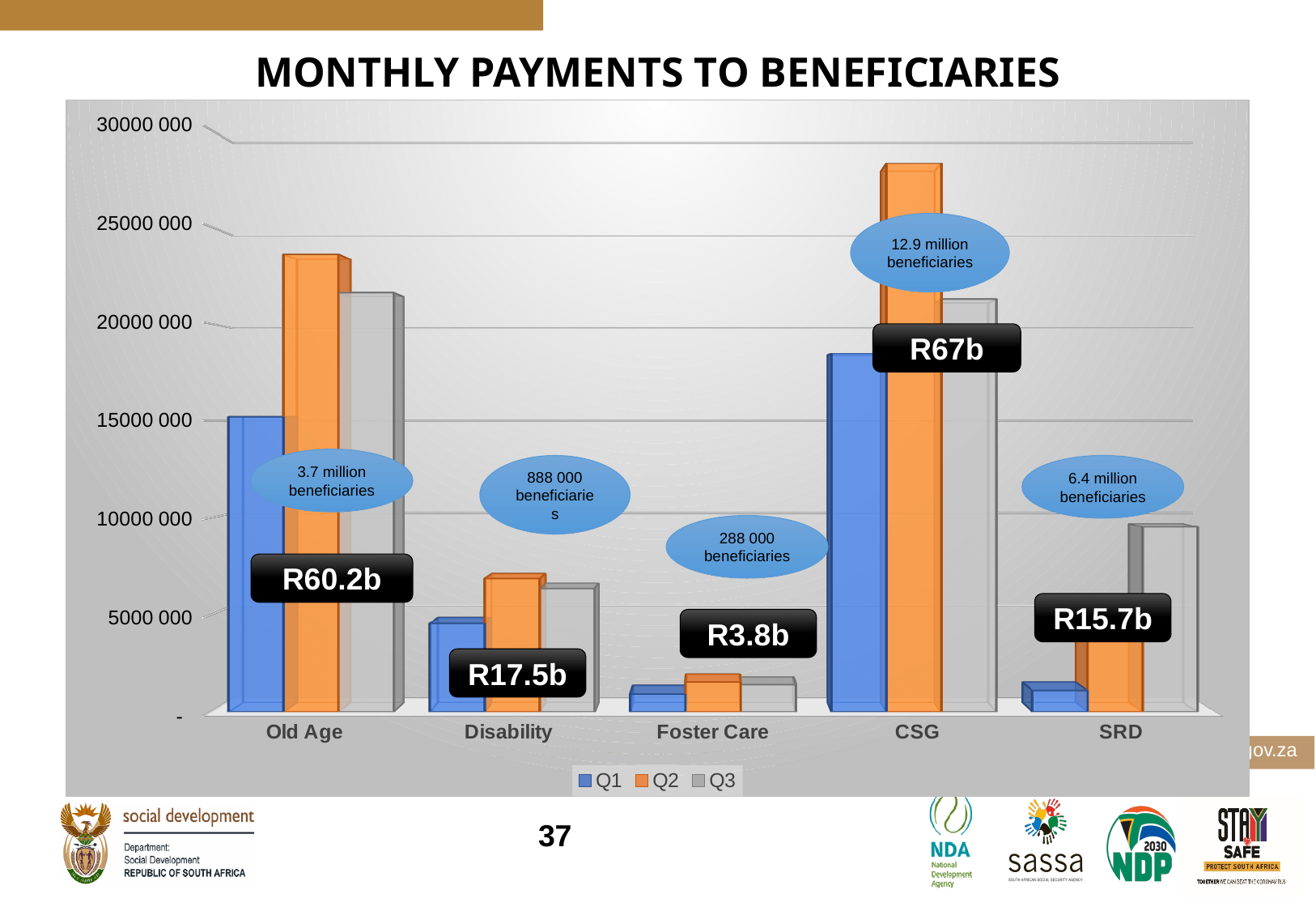
How many series does the chart legend list? 3 Which is larger, the Q2 value for Old Age or the Q2 value for Disability? Old Age How many categories are shown on the x axis of the chart? 5 Is the Q2 value for Old Age greater or less than 20000 000? greater Is the Q2 value for CSG greater or less than 25000 000? greater What is the title of the chart? MONTHLY PAYMENTS TO BENEFICIARIES What kind of chart is shown on the slide? bar chart Which category has the lowest Q2 bar? Foster Care How many beneficiaries are labelled for SRD on the chart? 6.4 million beneficiaries Which category has the highest Q2 bar? CSG What total payment amount is labelled for CSG on the chart? R67b